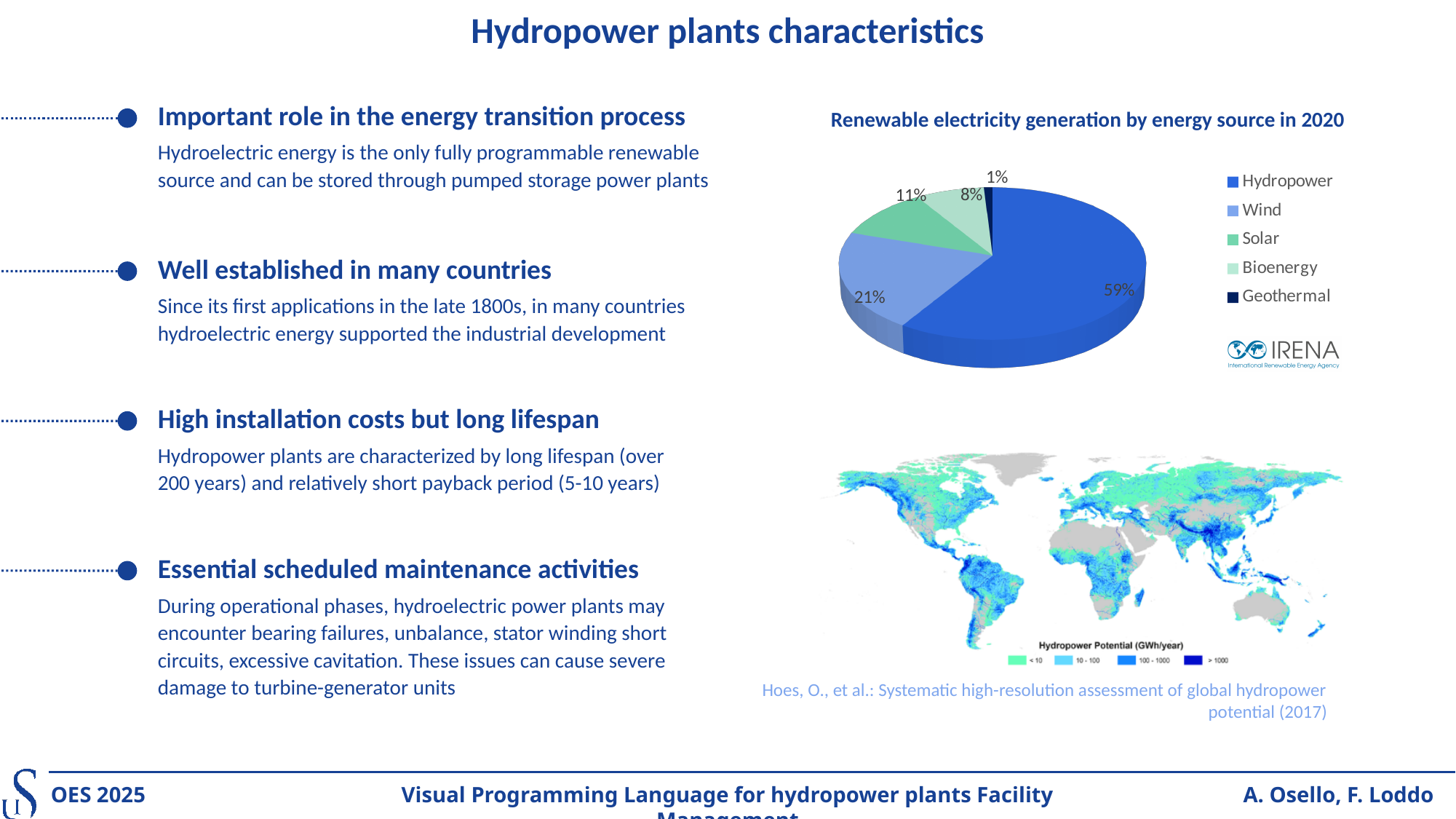
What percentage is shown for Solar in the pie chart? 11% How many energy sources are shown in the pie chart? 5 What type of chart is used to show renewable electricity generation by energy source in 2020? Pie chart What is the difference in percentage points between Hydropower and Wind in the pie chart? 38 What share of the pie chart does Wind account for? 21% What share of renewable electricity generation does Hydropower have in the pie chart? 59% Which has a larger share in the pie chart, Solar or Bioenergy? Solar What percentage is shown for Bioenergy in the pie chart? 8% Which energy source has the largest slice in the pie chart? Hydropower What is the title of the pie chart? Renewable electricity generation by energy source in 2020 What percentage is shown for Geothermal in the pie chart? 1% Which energy source has the smallest slice in the pie chart? Geothermal